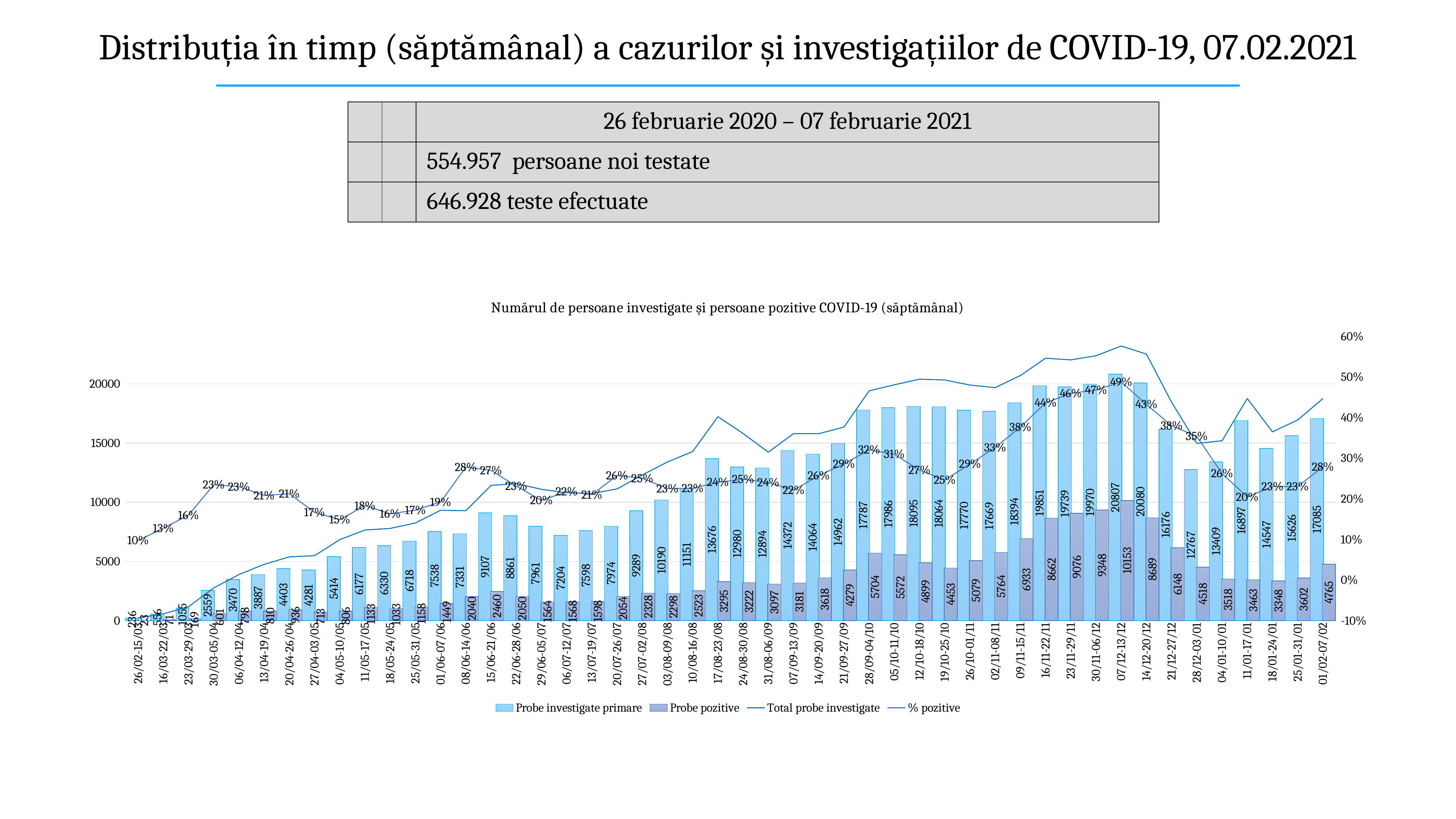
What is the difference between Probe investigate primare and Probe pozitive for the week 07/12-13/12? 10654 What kind of chart is shown on the slide? Combined bar and line chart Which week has the lowest value of Probe pozitive? 26/02-15/03 What is the value of Probe pozitive for the week 01/02-07/02? 4765 Which week has the highest value of Probe investigate primare? 07/12-13/12 How many series does the legend list? 4 What is the value of Probe investigate primare for the week 07/12-13/12? 20807 Which is larger: Probe investigate primare for 11/01-17/01 or for 18/01-24/01? 11/01-17/01 Which week has the highest % pozitive value? 07/12-13/12 What is the title of the chart? Numărul de persoane investigate și persoane pozitive COVID-19 (săptămânal) What is the % pozitive value for the week 16/11-22/11? 44% Is the value of Probe investigate primare for the week 28/09-04/10 greater or less than 15000? greater